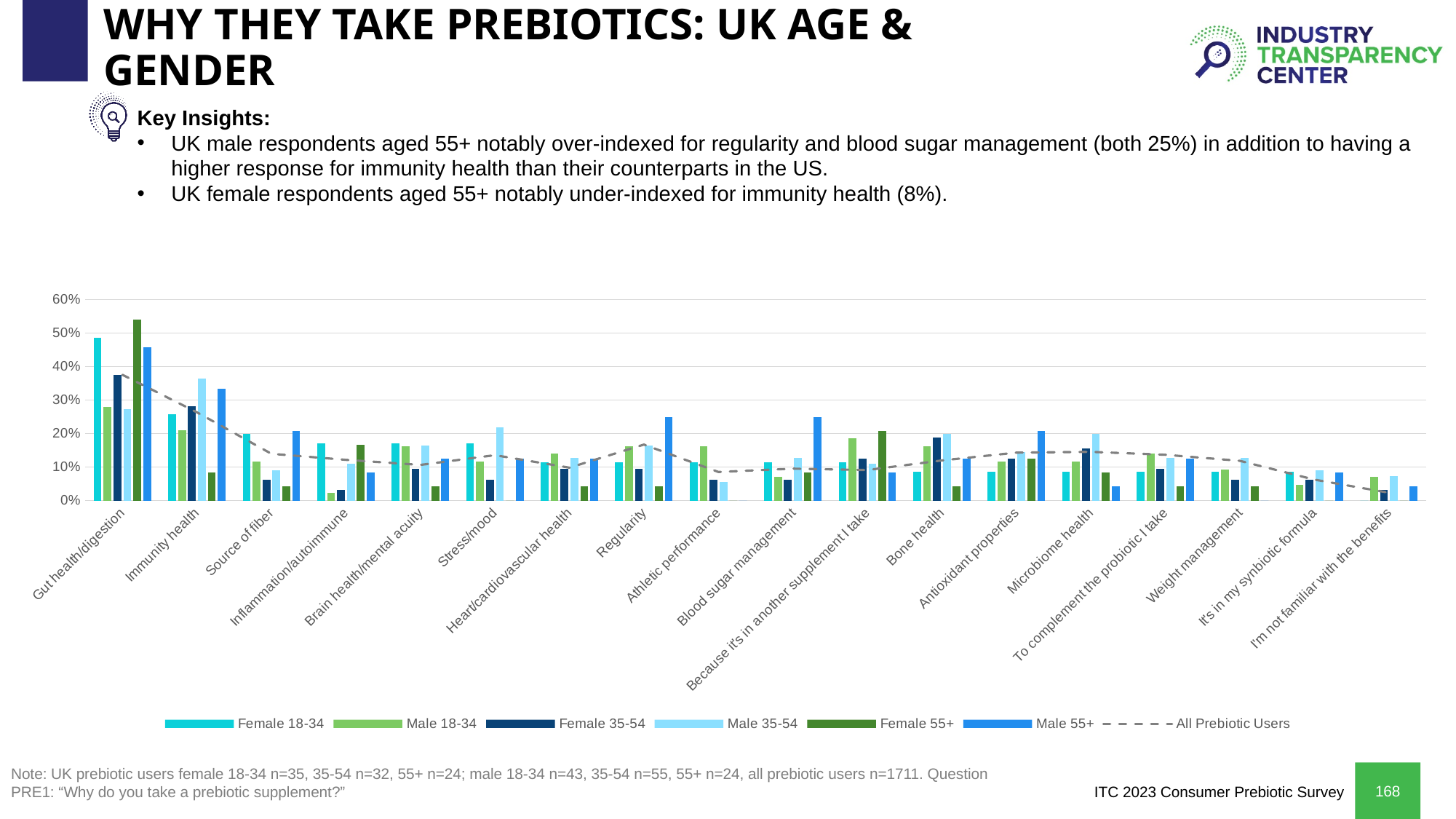
Which series is drawn as a dashed line rather than bars? All Prebiotic Users Is the value for Male 35-54 on Immunity health greater or less than 30%? greater Which series has the highest bar for Gut health/digestion? Female 55+ How many reason categories are shown along the x axis? 18 Which category has the tallest bar in the chart? Gut health/digestion Is the value for Male 55+ on Regularity greater or less than 20%? greater What kind of chart is shown on the slide? combination bar and line chart Does the All Prebiotic Users dashed line generally rise or fall from left to right across the categories? fall Is the value for Female 55+ on Gut health/digestion greater or less than 50%? greater How many series does the legend list? 7 For Gut health/digestion, which is larger: Female 18-34 or Female 35-54? Female 18-34